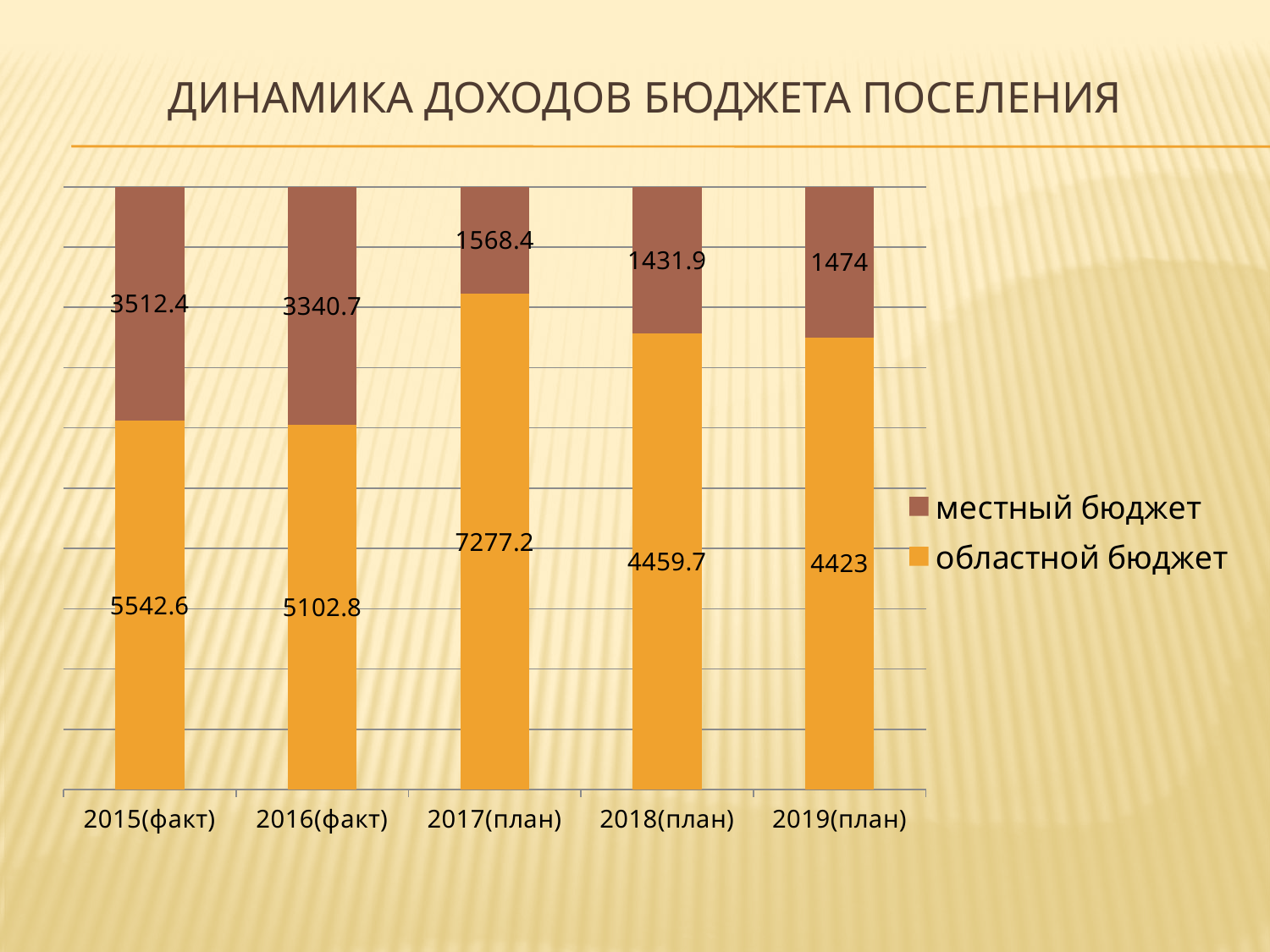
Which category has the lowest value for местный бюджет? 2018(план) Which category has the highest value for областной бюджет? 2017(план) Does the value of местный бюджет rise or fall from 2015(факт) to 2018(план)? Fall What is the value of областной бюджет for 2019(план)? 4423 What is the value of местный бюджет for 2015(факт)? 3512.4 How many series does the legend list? 2 What kind of chart is shown on the slide? Stacked bar chart Which is larger: местный бюджет for 2016(факт) or местный бюджет for 2017(план)? 2016(факт) What is the difference between областной бюджет and местный бюджет for 2015(факт)? 2030.2 How many categories are shown on the x axis? 5 What is the total of the two labelled values for 2018(план)? 5891.6 What is the value of областной бюджет for 2017(план)? 7277.2